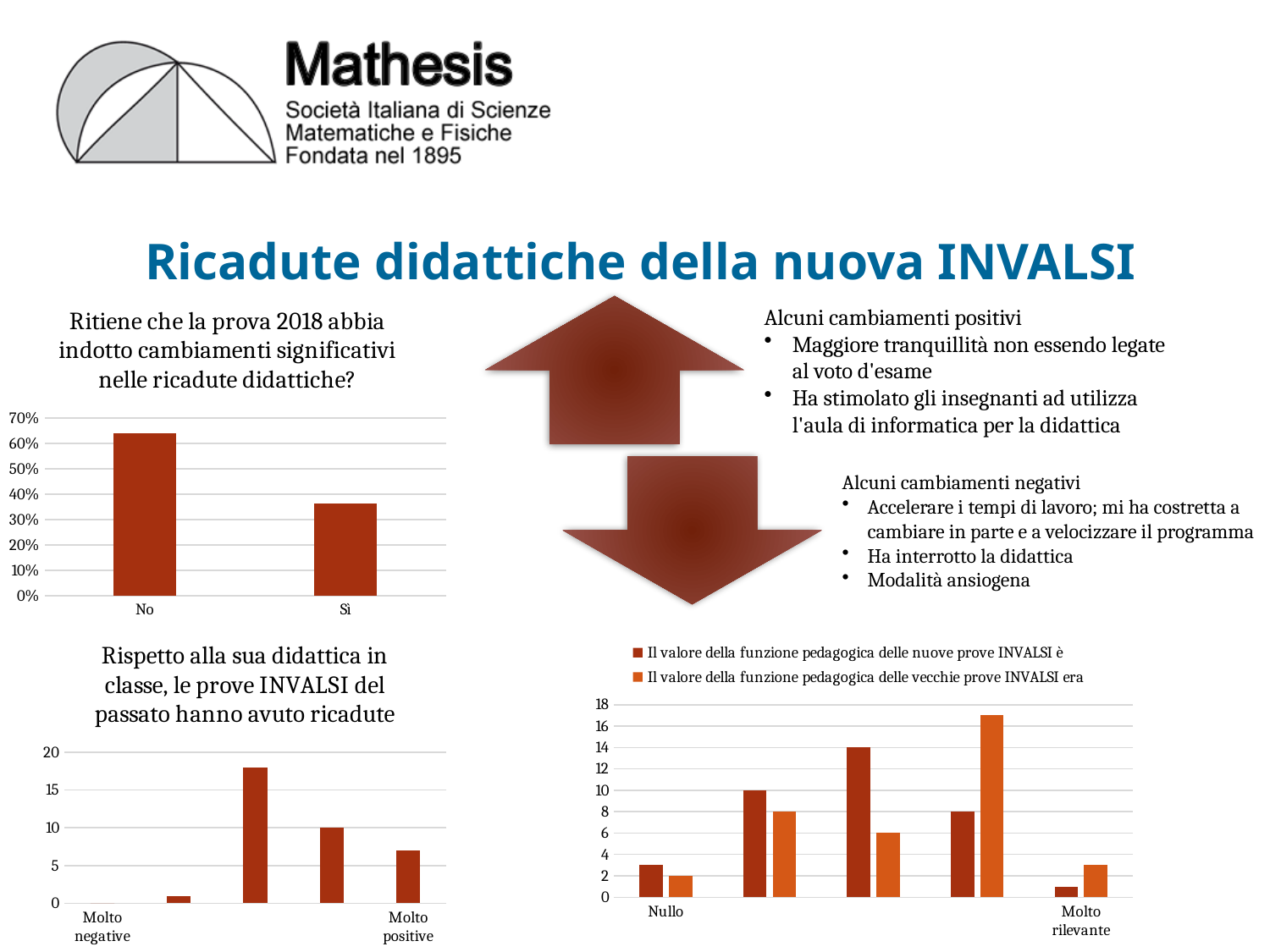
How many categories are shown in the chart titled 'Ritiene che la prova 2018 abbia indotto cambiamenti significativi nelle ricadute didattiche?'? 2 How many bars (categories) are there in the chart titled 'Rispetto alla sua didattica in classe, le prove INVALSI del passato hanno avuto ricadute'? 5 In the bottom-right chart, for the category Molto rilevante, which series has the larger value? Il valore della funzione pedagogica delle vecchie prove INVALSI era What kind of chart is the one titled 'Rispetto alla sua didattica in classe, le prove INVALSI del passato hanno avuto ricadute'? bar chart In the chart titled 'Rispetto alla sua didattica in classe, le prove INVALSI del passato hanno avuto ricadute', which has the larger value, Molto negative or Molto positive? Molto positive In the chart titled 'Rispetto alla sua didattica in classe, le prove INVALSI del passato hanno avuto ricadute', is the value for Molto positive greater or less than 10? less In the bottom-right chart, what is the value for Nullo in the series 'Il valore della funzione pedagogica delle vecchie prove INVALSI era'? 2 In the chart titled 'Ritiene che la prova 2018 abbia indotto cambiamenti significativi nelle ricadute didattiche?', which category has the higher value, No or Sì? No In the chart titled 'Ritiene che la prova 2018 abbia indotto cambiamenti significativi nelle ricadute didattiche?', is the value for Sì greater or less than 40%? less In the chart titled 'Ritiene che la prova 2018 abbia indotto cambiamenti significativi nelle ricadute didattiche?', is the value for No greater or less than 60%? greater How many series does the legend list in the bottom-right chart (the one with categories Nullo to Molto rilevante)? 2